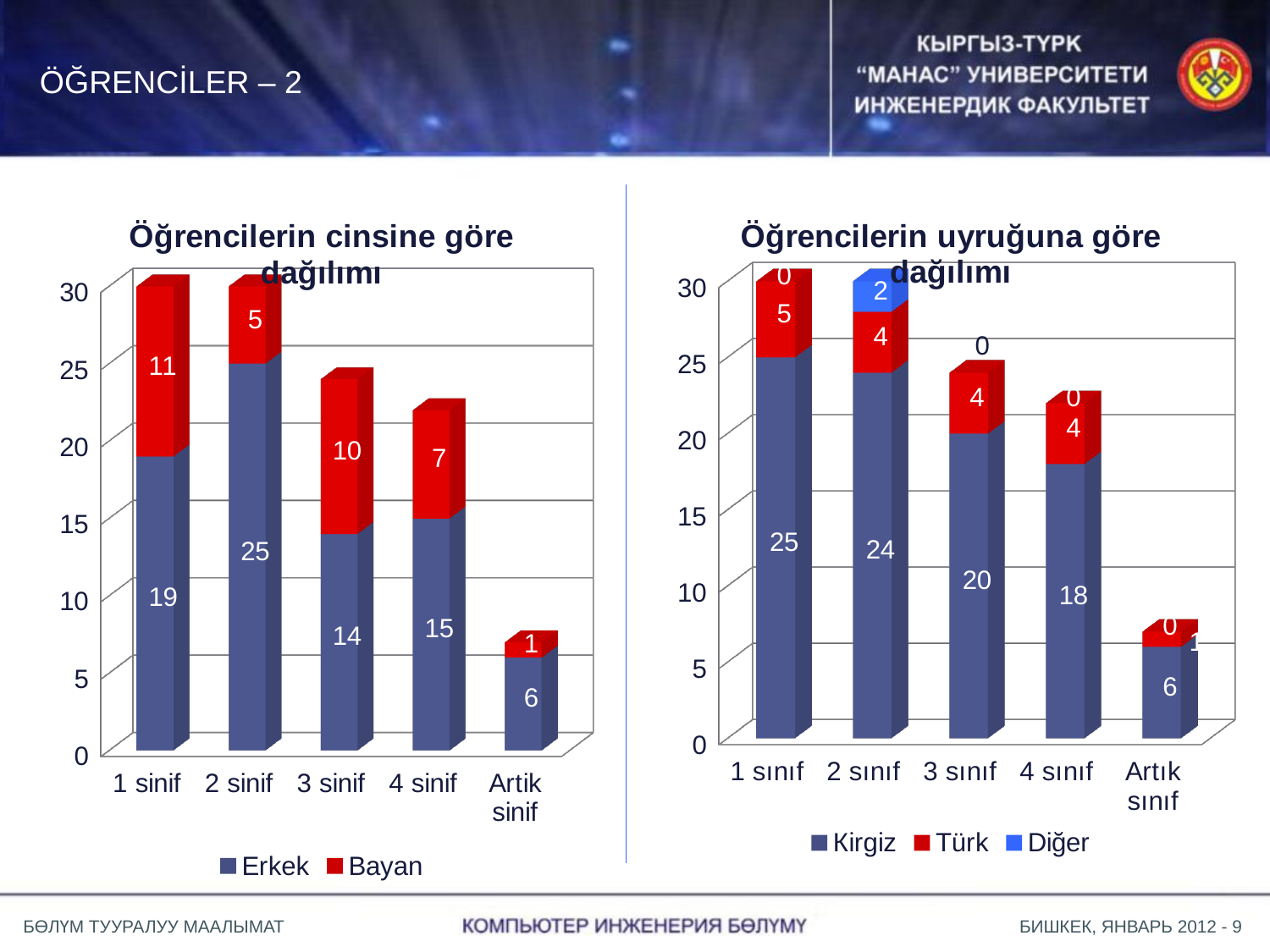
In the chart titled 'Öğrencilerin cinsine göre dağılımı', what is the difference between the Erkek and Bayan values for 1 sinif? 8 In the chart titled 'Öğrencilerin uyruğuna göre dağılımı', which category has the highest Kirgiz value? 1 sınıf In the chart titled 'Öğrencilerin uyruğuna göre dağılımı', what is the total of the stacked bar for 2 sınıf? 30 In the chart titled 'Öğrencilerin uyruğuna göre dağılımı', what is the Diğer value for 2 sınıf? 2 In the chart titled 'Öğrencilerin uyruğuna göre dağılımı', what is the Kirgiz value for 3 sınıf? 20 What kind of chart is the one titled 'Öğrencilerin uyruğuna göre dağılımı'? Stacked bar chart In the chart titled 'Öğrencilerin cinsine göre dağılımı', what is the Erkek value for 2 sinif? 25 In the chart titled 'Öğrencilerin cinsine göre dağılımı', what is the Bayan value for 3 sinif? 10 In the chart titled 'Öğrencilerin cinsine göre dağılımı', which category has the lowest Erkek value? Artik sinif In the chart titled 'Öğrencilerin uyruğuna göre dağılımı', how many categories are shown on the x axis? 5 In the chart titled 'Öğrencilerin cinsine göre dağılımı', how many series does the legend list? 2 In the chart titled 'Öğrencilerin cinsine göre dağılımı', what is the total of the stacked bar for 4 sinif? 22